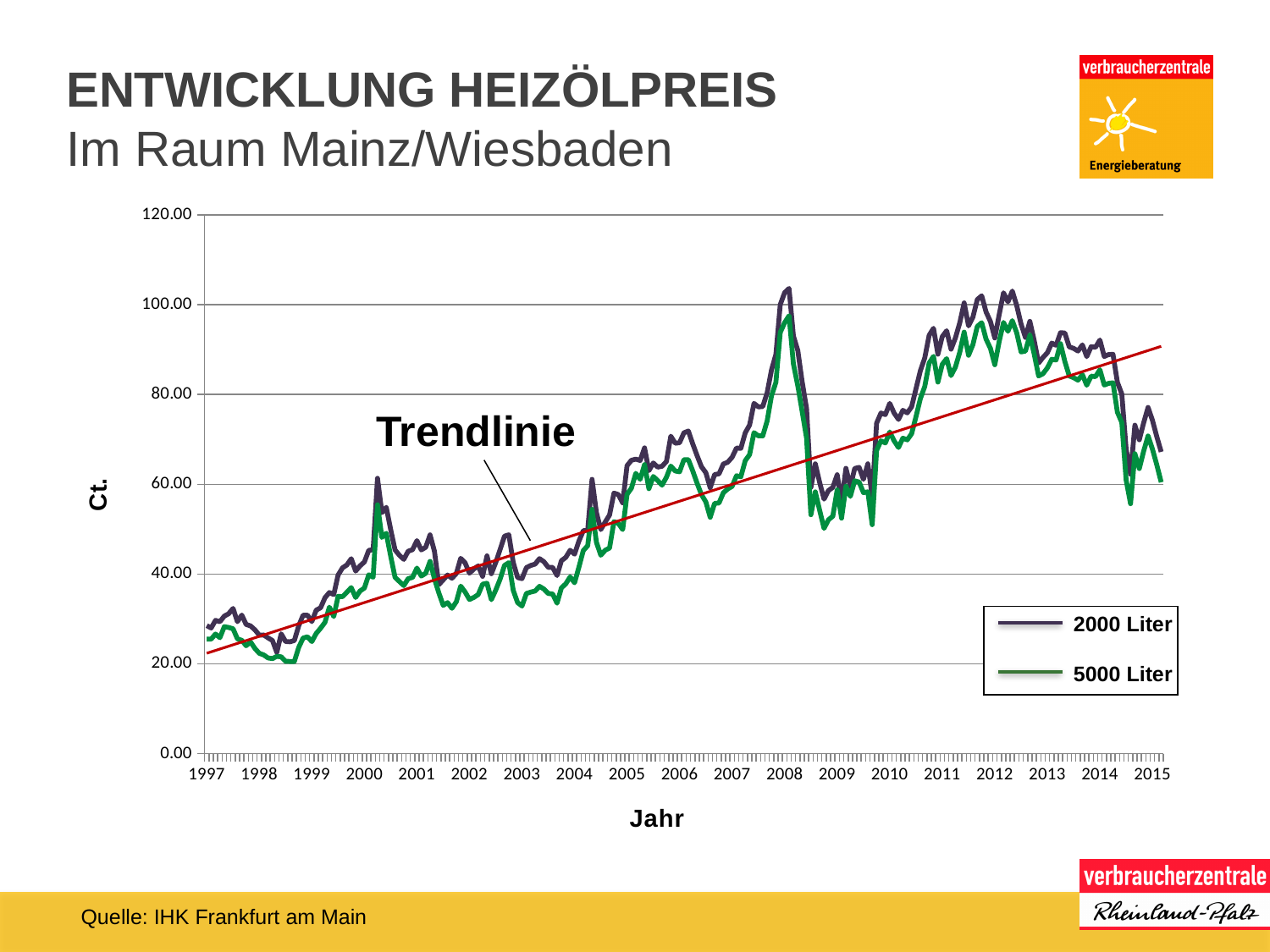
What are the two series named in the legend? 2000 Liter and 5000 Liter Which series generally shows the higher price, 2000 Liter or 5000 Liter? 2000 Liter Is the peak value of the 2000 Liter series in 2008 greater or less than 80.00? greater How many series does the legend list? 2 What is the label of the red straight line on the chart? Trendlinie What kind of chart is shown on the slide? line chart Is the lowest value of the 5000 Liter series around 1998 greater or less than 40.00? less Overall, do the heating oil prices rise or fall from 1997 to 2015 according to the trend line? rise In which year does the 2000 Liter series reach its highest peak? 2008 Is the value of the 2000 Liter series at the start of 1997 greater or less than 40.00? less Around which year does the 5000 Liter series reach its lowest value? 1998 How many year labels are shown on the x axis? 19